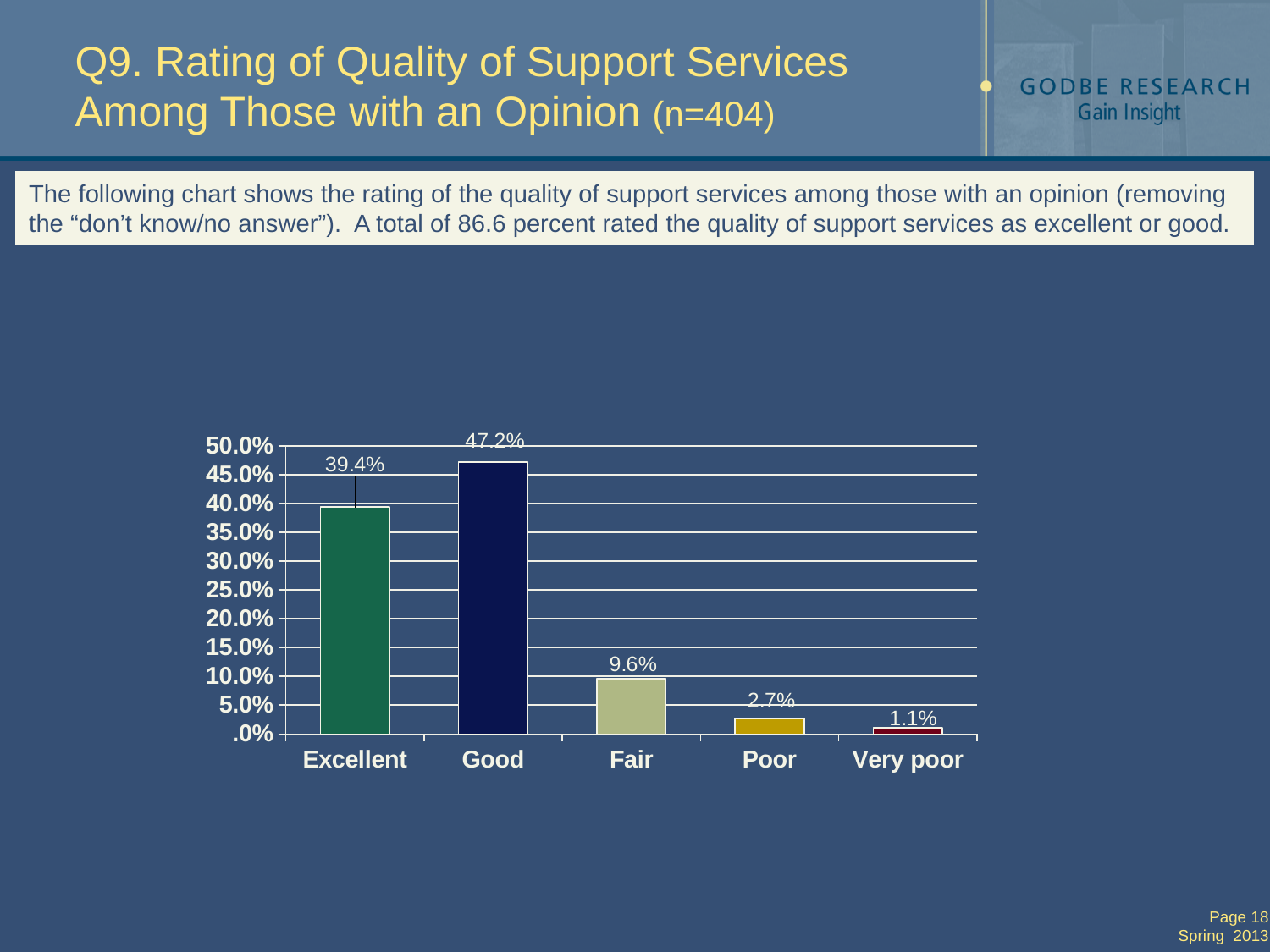
What is the value for Good? 47.2% What is the value for Fair? 9.6% What kind of chart is shown on the slide? Bar chart What is the value for Poor? 2.7% Is the value for Excellent greater or less than 35.0%? greater How many categories are shown on the x axis? 5 What is the value for Excellent? 39.4% Which category has the lowest value? Very poor Which category has the highest value? Good Which is larger, the value for Fair or the value for Poor? Fair What is the difference between the values for Good and Excellent? 7.8% What is the value for Very poor? 1.1%